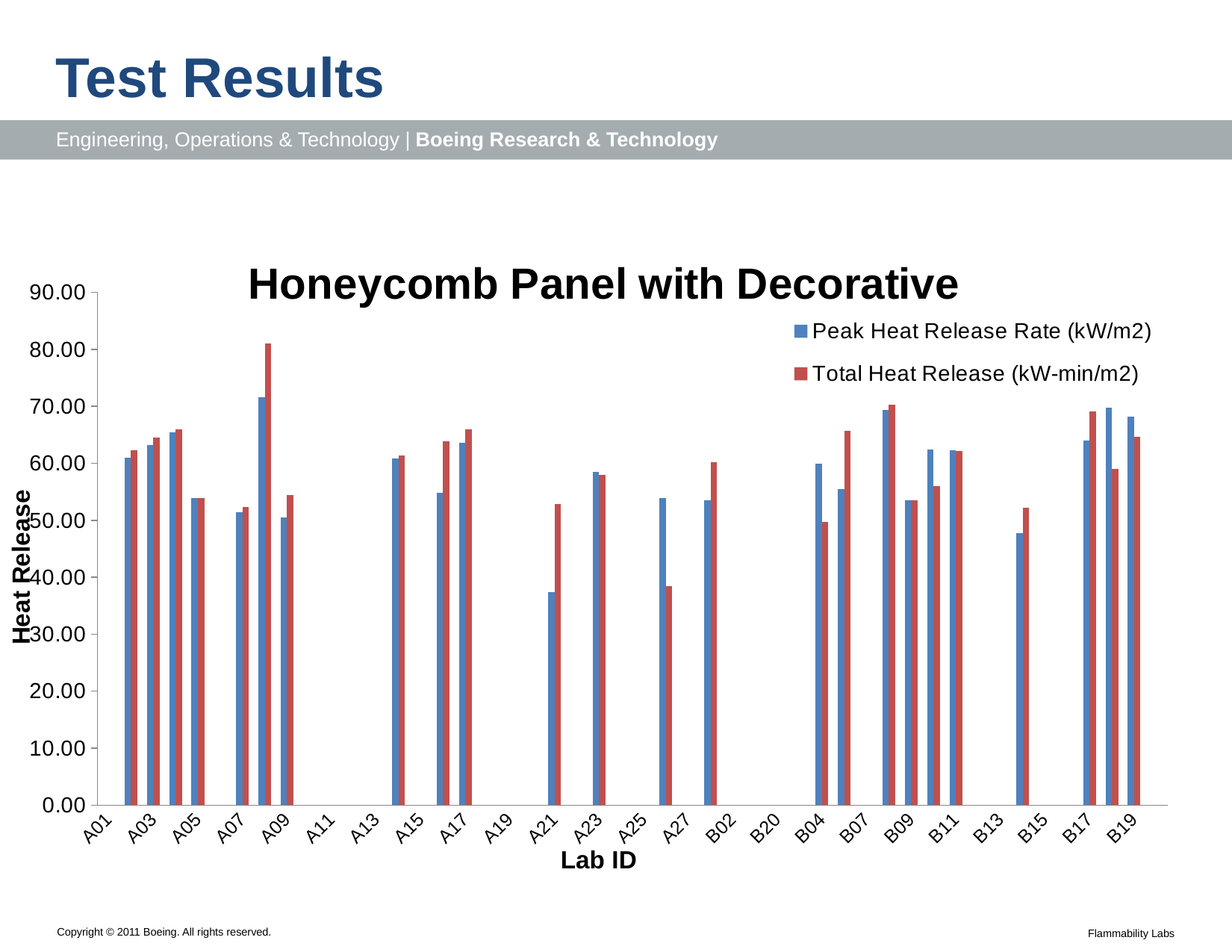
Is the Peak Heat Release Rate (kW/m2) for A21 greater or less than 40.00? less For A21, which is larger: Peak Heat Release Rate (kW/m2) or Total Heat Release (kW-min/m2)? Total Heat Release (kW-min/m2) What is the title of the chart? Honeycomb Panel with Decorative What kind of chart is shown on the slide? bar chart Which Lab ID has the lowest Peak Heat Release Rate (kW/m2)? A21 What is the label of the x axis? Lab ID How many series does the legend list? 2 Is the Total Heat Release (kW-min/m2) for A09 greater or less than 70.00? less